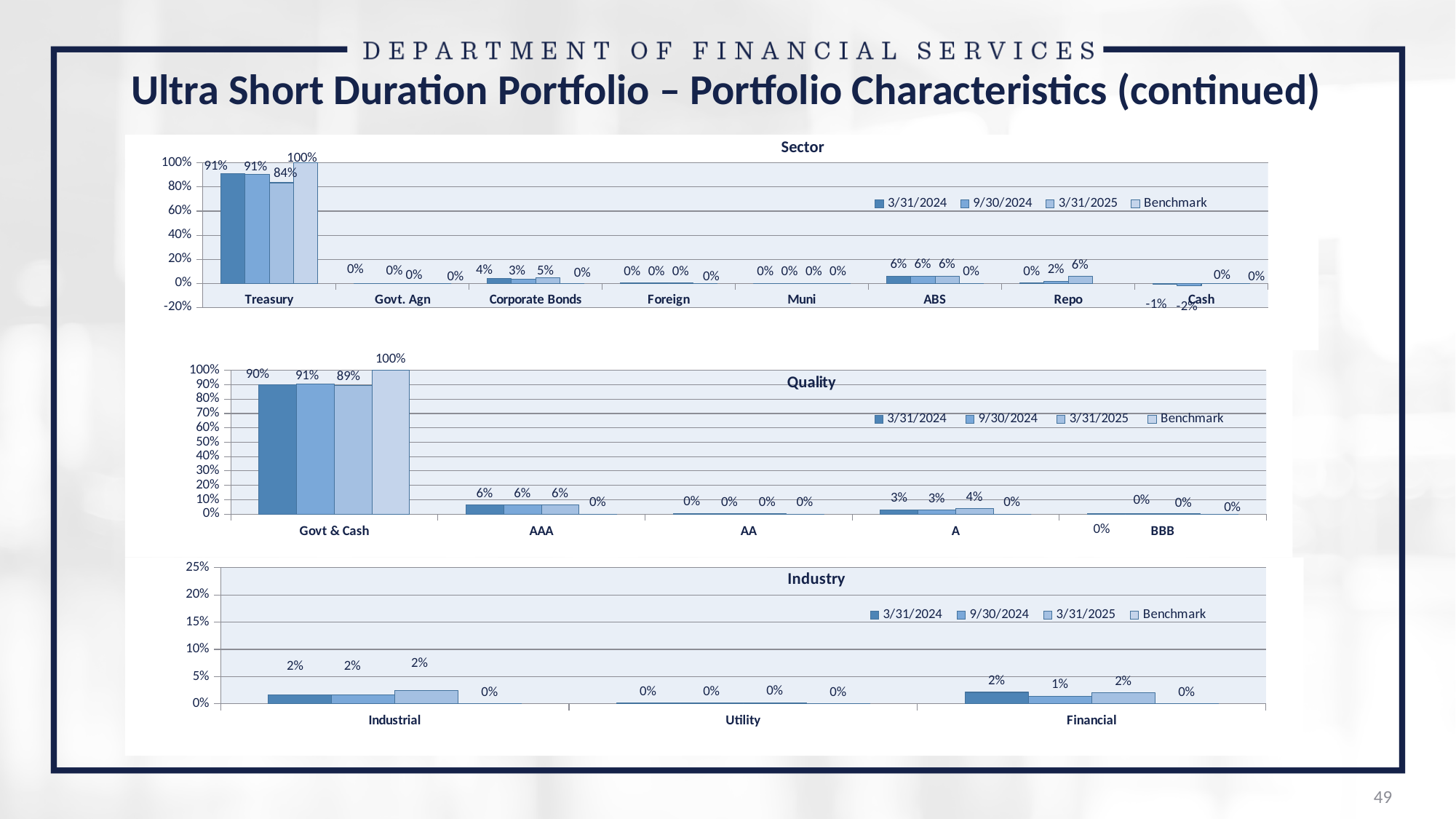
In the Industry chart, what is the Financial value for 9/30/2024? 1% In the Sector chart, what is the difference between the 3/31/2025 and 9/30/2024 values for Repo? 4% What kind of chart is the Industry chart? bar chart In the Sector chart, what is the Treasury value for 3/31/2025? 84% In the Industry chart, is the 3/31/2024 value for Industrial larger or smaller than the 9/30/2024 value for Financial? larger In the Quality chart, what is the A value for 3/31/2025? 4% In the Sector chart, what is the Benchmark value for Treasury? 100% How many series does the legend of the Sector chart list? 4 In the Sector chart, what is the Cash value for 9/30/2024? -2% In the Quality chart, what is the Govt & Cash value for 3/31/2025? 89% How many quality categories are shown on the x axis of the Quality chart? 5 In the Sector chart, which sector has the highest 3/31/2024 value? Treasury